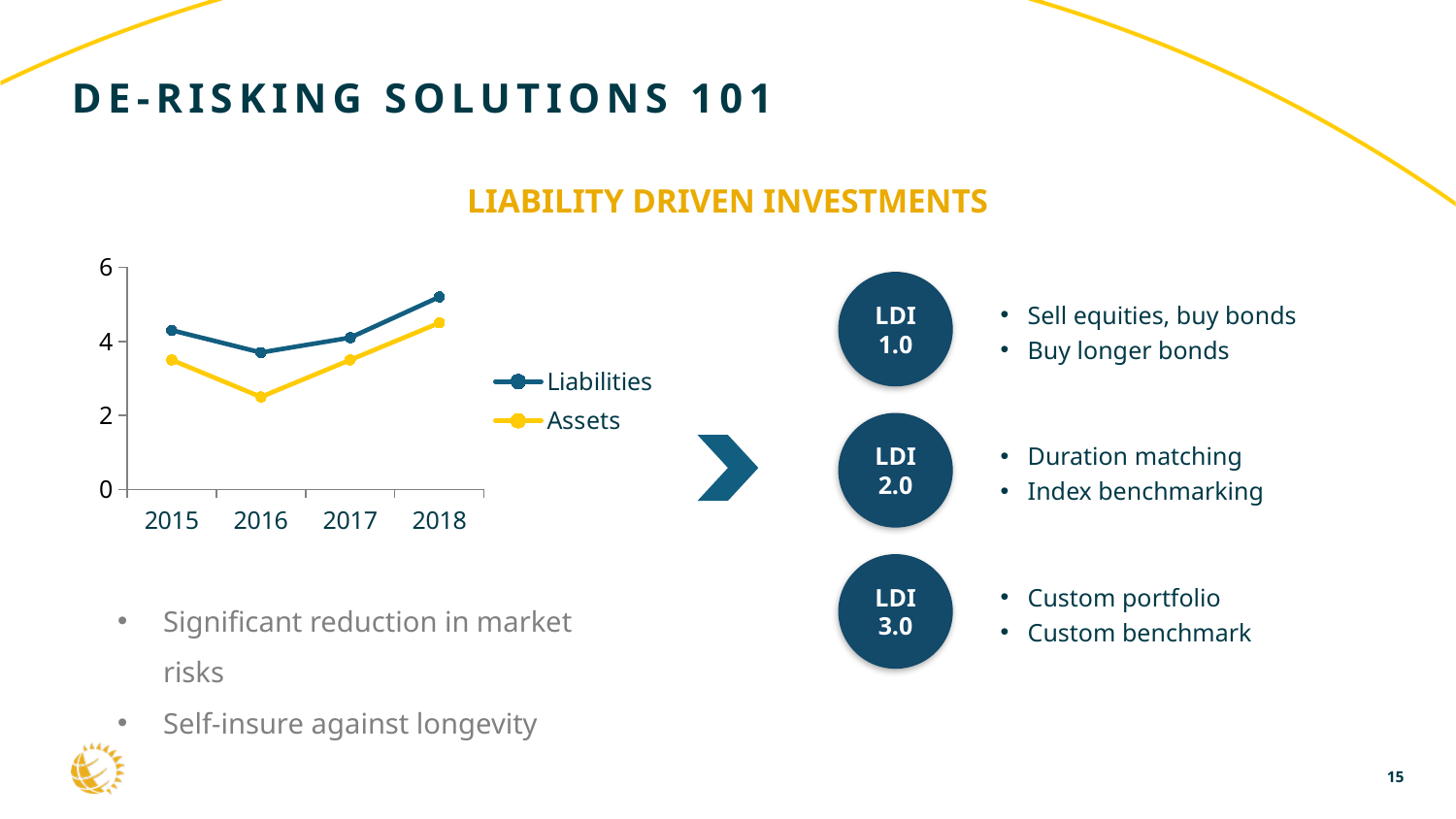
Which series are listed in the chart's legend? Liabilities and Assets How many years are plotted along the x axis of the chart? 4 In which year is the Liabilities line at its highest? 2018 What colour is the Assets line in the chart? yellow Is the value for Assets in 2018 greater or less than 4? greater How many series does the chart's legend list? 2 Is the value for Liabilities in 2018 greater or less than 4? greater Do the Liabilities values rise or fall from 2016 to 2018? rise In which year is the Assets line at its lowest? 2016 What kind of chart is shown on the slide? line chart In 2016, which is larger, Liabilities or Assets? Liabilities Is the value for Assets in 2016 greater or less than 4? less